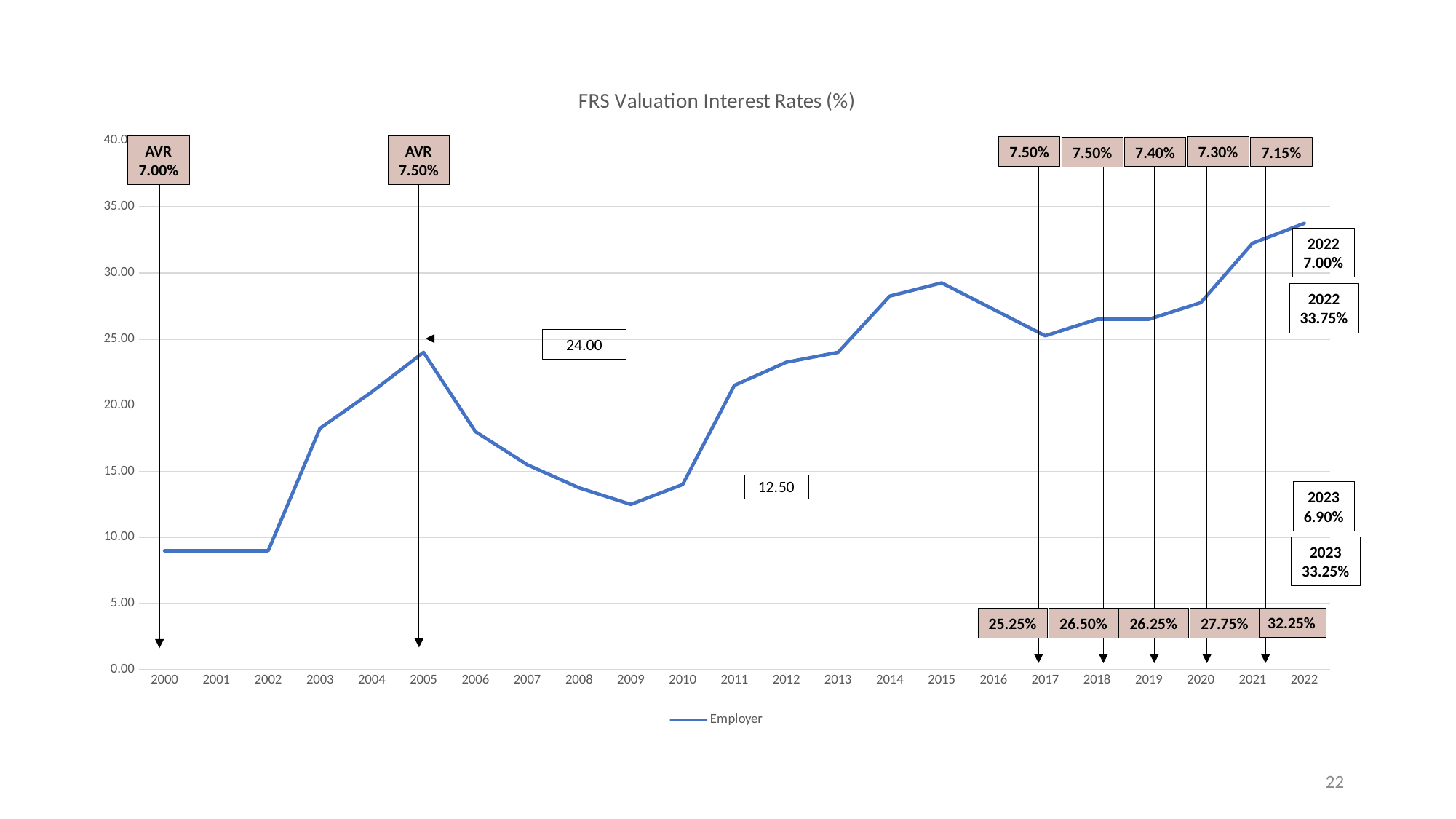
What is the name of the series shown in the legend? Employer What value is labelled for the Employer line in 2009? 12.50 Does the Employer line rise or fall between 2005 and 2009? fall Is the Employer value for 2015 greater or less than 25.00? greater How many years are shown on the x axis? 23 What is the title of the chart? FRS Valuation Interest Rates (%) What is the labelled Employer rate for 2017? 25.25% What is the labelled Employer rate for 2021? 32.25% How many series does the legend list? 1 Which year has the highest plotted Employer value? 2022 What kind of chart is shown on the slide? line chart What value is labelled for the Employer line in 2005? 24.00